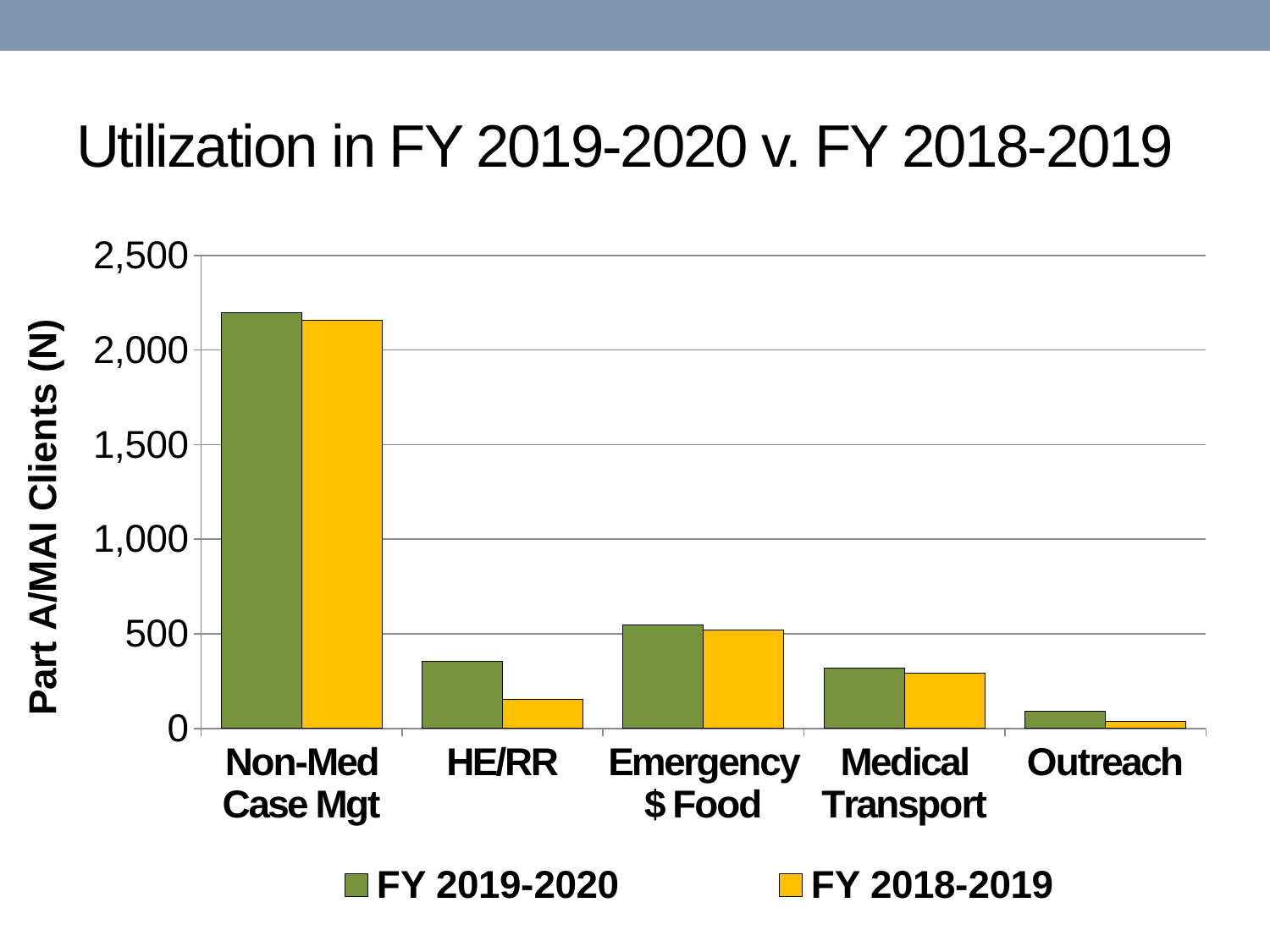
How many series does the legend list? 2 Is the FY 2018-2019 value for HE/RR greater or less than 500? less Is the FY 2019-2020 value for Non-Med Case Mgt greater or less than 2,000? greater How many service categories are shown on the x axis? 5 For Outreach, which is larger: the FY 2019-2020 value or the FY 2018-2019 value? FY 2019-2020 Which category has the lowest number of Part A/MAI clients in FY 2018-2019? Outreach Is the FY 2019-2020 value for Medical Transport greater or less than 500? less For HE/RR, which is larger: the FY 2019-2020 value or the FY 2018-2019 value? FY 2019-2020 What kind of chart is shown on the slide? bar chart What is the label of the y axis? Part A/MAI Clients (N) Which category has the highest number of Part A/MAI clients in FY 2019-2020? Non-Med Case Mgt